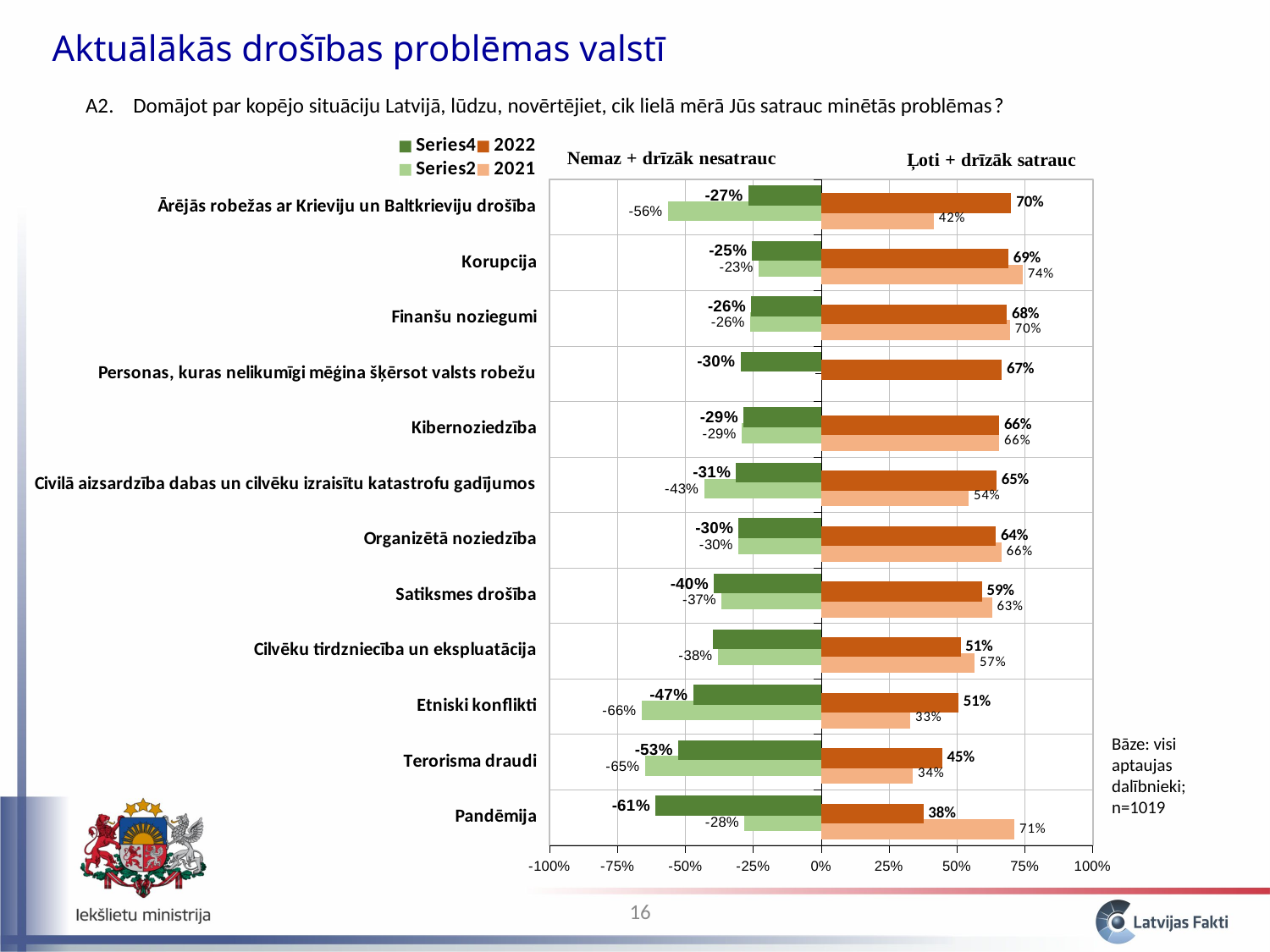
For Korupcija, which 'Ļoti + drīzāk satrauc' value is larger, 2022 or 2021? 2021 For Etniski konflikti, what is the difference between the 2022 (51%) and 2021 (33%) 'Ļoti + drīzāk satrauc' values? 18 percentage points What is the 2021 'Ļoti + drīzāk satrauc' value (light orange bar) for Pandēmija? 71% What is the range of the horizontal axis on the chart? -100% to 100% What type of chart is shown on the slide? Bar chart What is the 2021 'Nemaz + drīzāk nesatrauc' value (light green bar) for Terorisma draudi? -65% What is the 2022 'Ļoti + drīzāk satrauc' value (dark orange bar) for Korupcija? 69% Which category has the lowest 2022 'Ļoti + drīzāk satrauc' value (dark orange bar)? Pandēmija How many series does the chart legend list? 4 How many categories (security problems) are listed on the chart? 12 What is the dark green 'Nemaz + drīzāk nesatrauc' value for Pandēmija? -61% Which category has the highest 2022 'Ļoti + drīzāk satrauc' value (dark orange bar)? Ārējās robežas ar Krieviju un Baltkrieviju drošība